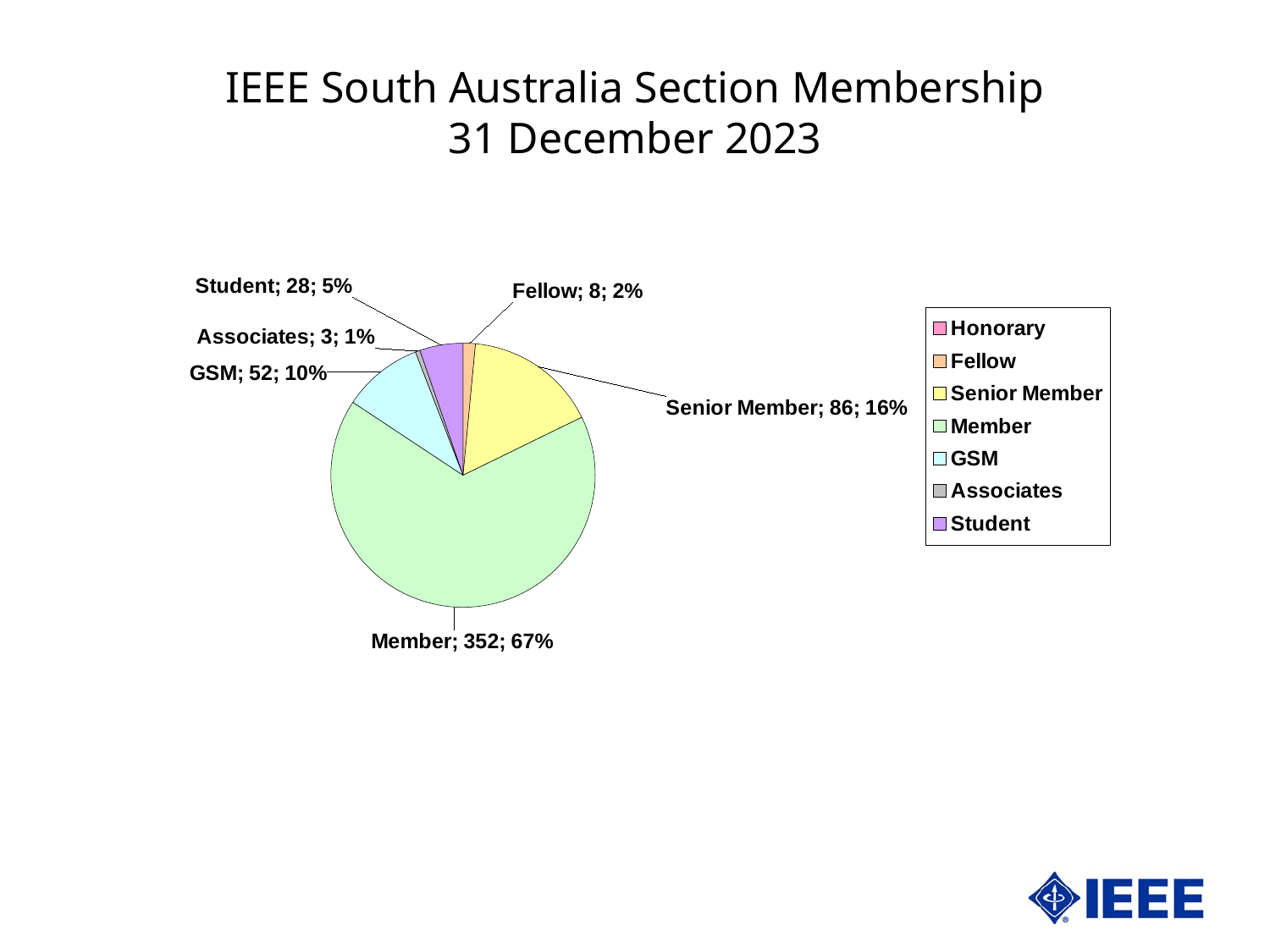
How many members are in the GSM category? 52 How many categories does the legend list? 7 What is the value shown for Fellow? 8 Which category has the largest slice of the pie? Member What percentage share does the Student slice have? 5% How many members are in the Member category? 352 Which is larger, the GSM count or the Student count? GSM What percentage share does the Senior Member slice have? 16% What is the title of the slide? IEEE South Australia Section Membership 31 December 2023 What is the difference between the Member count and the Senior Member count? 266 Which labelled category has the smallest slice of the pie? Associates What type of chart is shown on the slide? pie chart